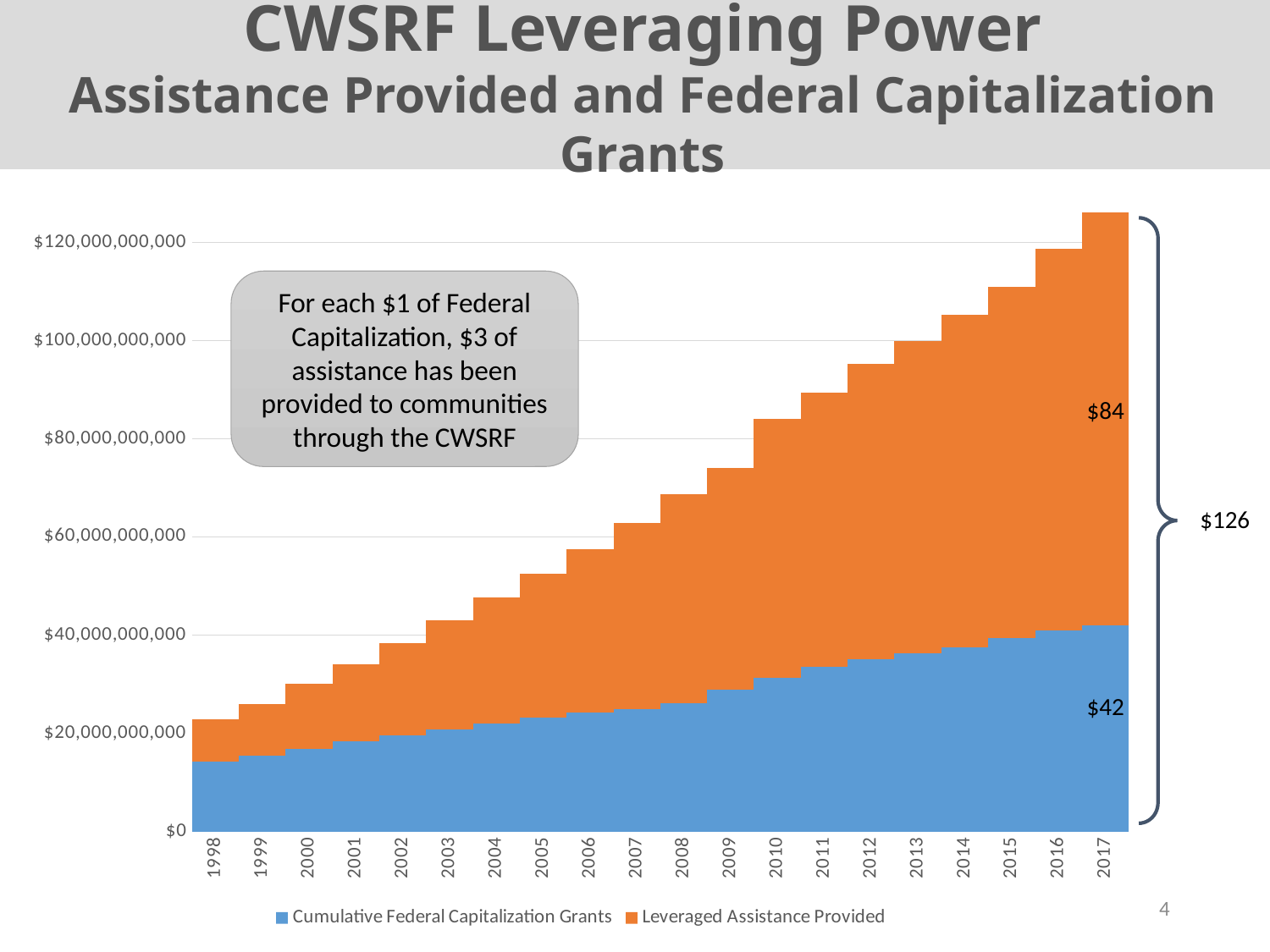
What is the total labelled for the 2017 bar? $126 What is the value labelled for Leveraged Assistance Provided in 2017? $84 Is the total value of the 2017 bar greater or less than $120,000,000,000? greater How many series does the legend list? 2 What kind of chart is shown on the slide? stacked bar chart What is the value labelled for Cumulative Federal Capitalization Grants in 2017? $42 Do the total bar heights rise or fall from 1998 to 2017? rise In 2017, which is larger: Leveraged Assistance Provided or Cumulative Federal Capitalization Grants? Leveraged Assistance Provided Is the Cumulative Federal Capitalization Grants value for 1998 greater or less than $20,000,000,000? less Which colour represents Leveraged Assistance Provided in the chart? orange How many years are shown on the x axis? 20 What is the difference between the Leveraged Assistance Provided and Cumulative Federal Capitalization Grants values labelled for 2017? $42